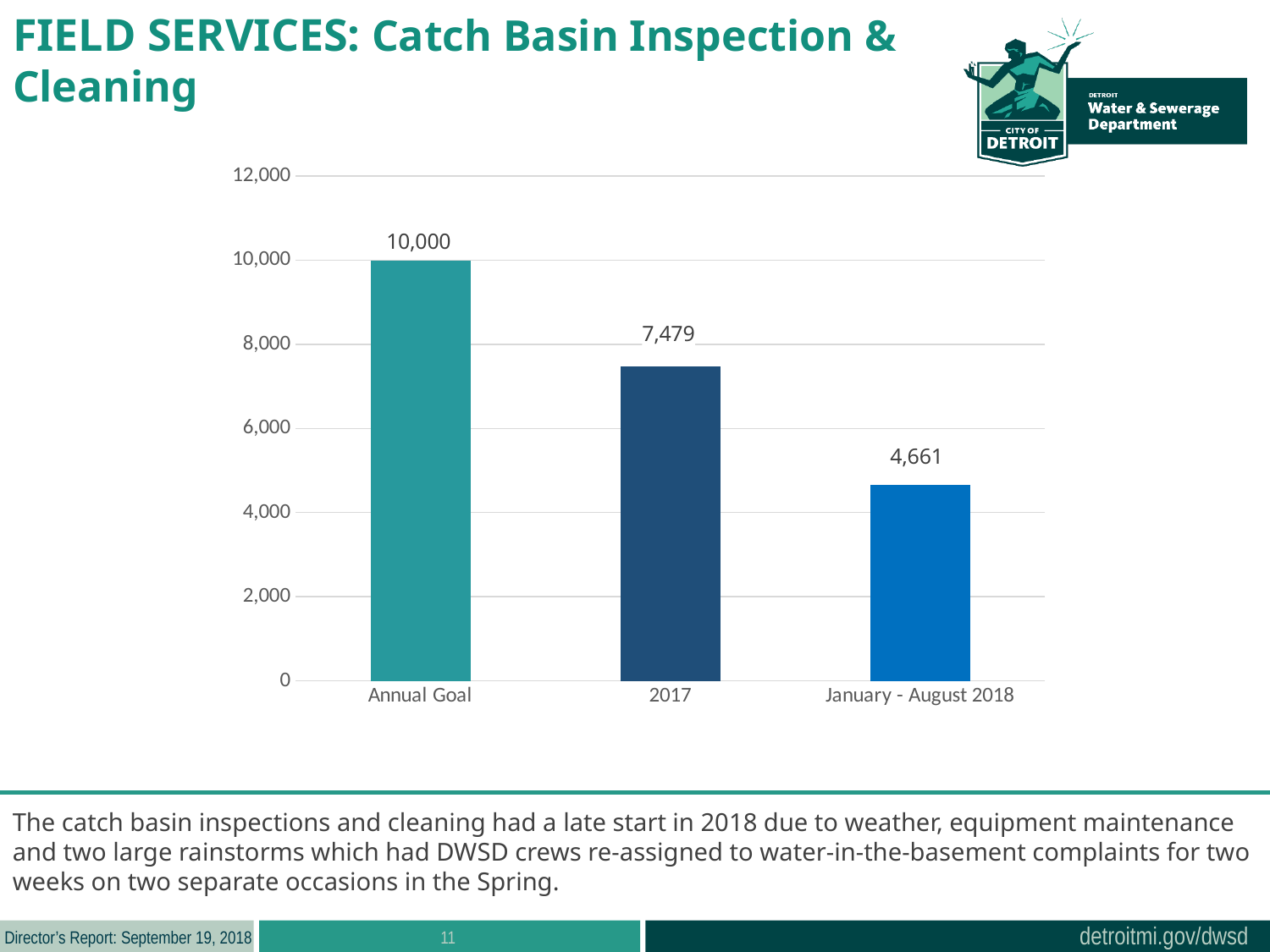
What kind of chart is shown on the slide? bar chart Is the value for January - August 2018 greater or less than 6,000? less What is the value for 2017? 7,479 Do the values rise or fall from left to right across the categories? fall Which is larger, the value for 2017 or the value for January - August 2018? 2017 Which category has the highest value? Annual Goal What is the difference between the Annual Goal and the 2017 value? 2,521 What is the value for Annual Goal? 10,000 What is the value for January - August 2018? 4,661 Which category has the lowest value? January - August 2018 What is the difference between the 2017 value and the January - August 2018 value? 2,818 How many categories are shown on the chart? 3